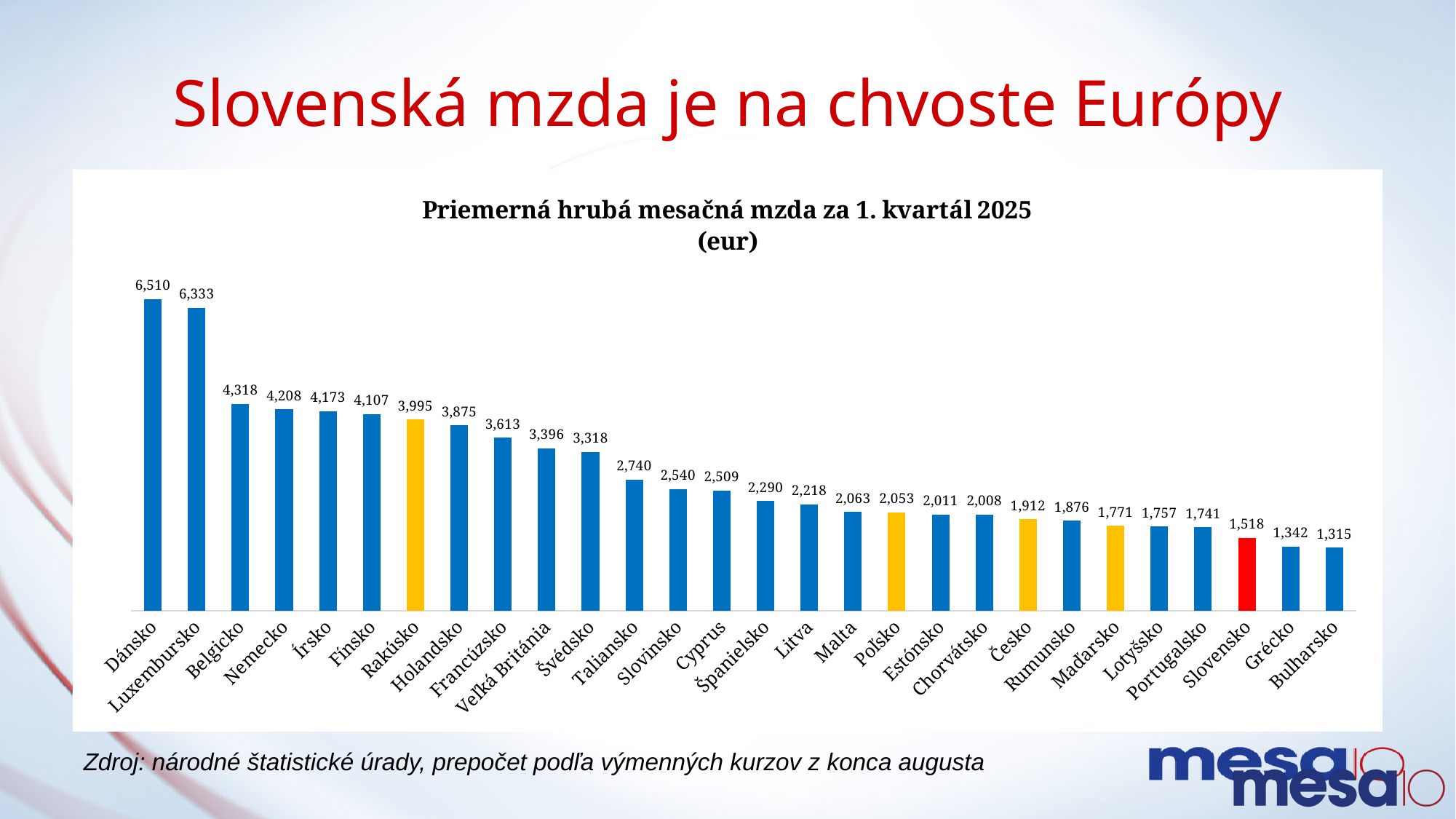
How many countries are shown in the chart? 28 Which is larger, the value for Maďarsko or the value for Lotyšsko? Maďarsko Which country has the highest average gross monthly wage? Dánsko What is the value for Slovensko? 1,518 Which country's bar is coloured red? Slovensko What is the difference between the values for Dánsko and Slovensko? 4,992 What is the value for Poľsko? 2,053 What kind of chart is shown on the slide? bar chart Do the values rise or fall from left to right along the x axis? fall Which country has the lowest average gross monthly wage? Bulharsko What is the value for Rakúsko? 3,995 What is the difference between the values for Česko and Slovensko? 394